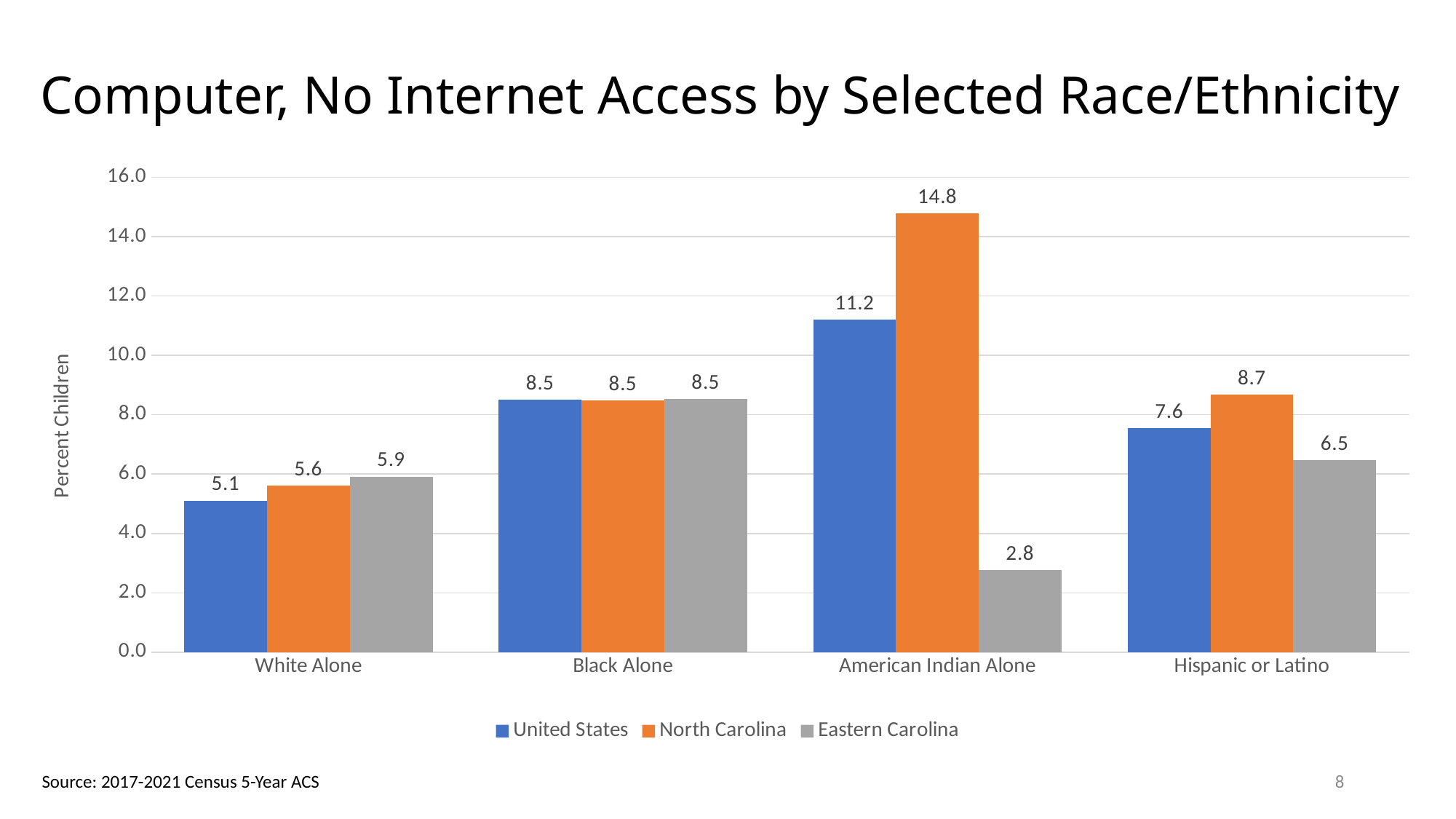
What is the value for North Carolina in the American Indian Alone category? 14.8 Which is larger in the Hispanic or Latino category: the North Carolina value or the Eastern Carolina value? North Carolina What is the difference between the North Carolina and Eastern Carolina values in the American Indian Alone category? 12.0 What is the value for United States in the Hispanic or Latino category? 7.6 What is the value for Eastern Carolina in the White Alone category? 5.9 What kind of chart is shown on the slide? Bar chart Which category has the lowest Eastern Carolina value? American Indian Alone What is the label of the y axis? Percent Children How many series does the legend list? 3 Is the United States value for American Indian Alone greater or less than 10.0? greater Which category has the highest North Carolina value? American Indian Alone How many race/ethnicity categories are shown on the x axis? 4